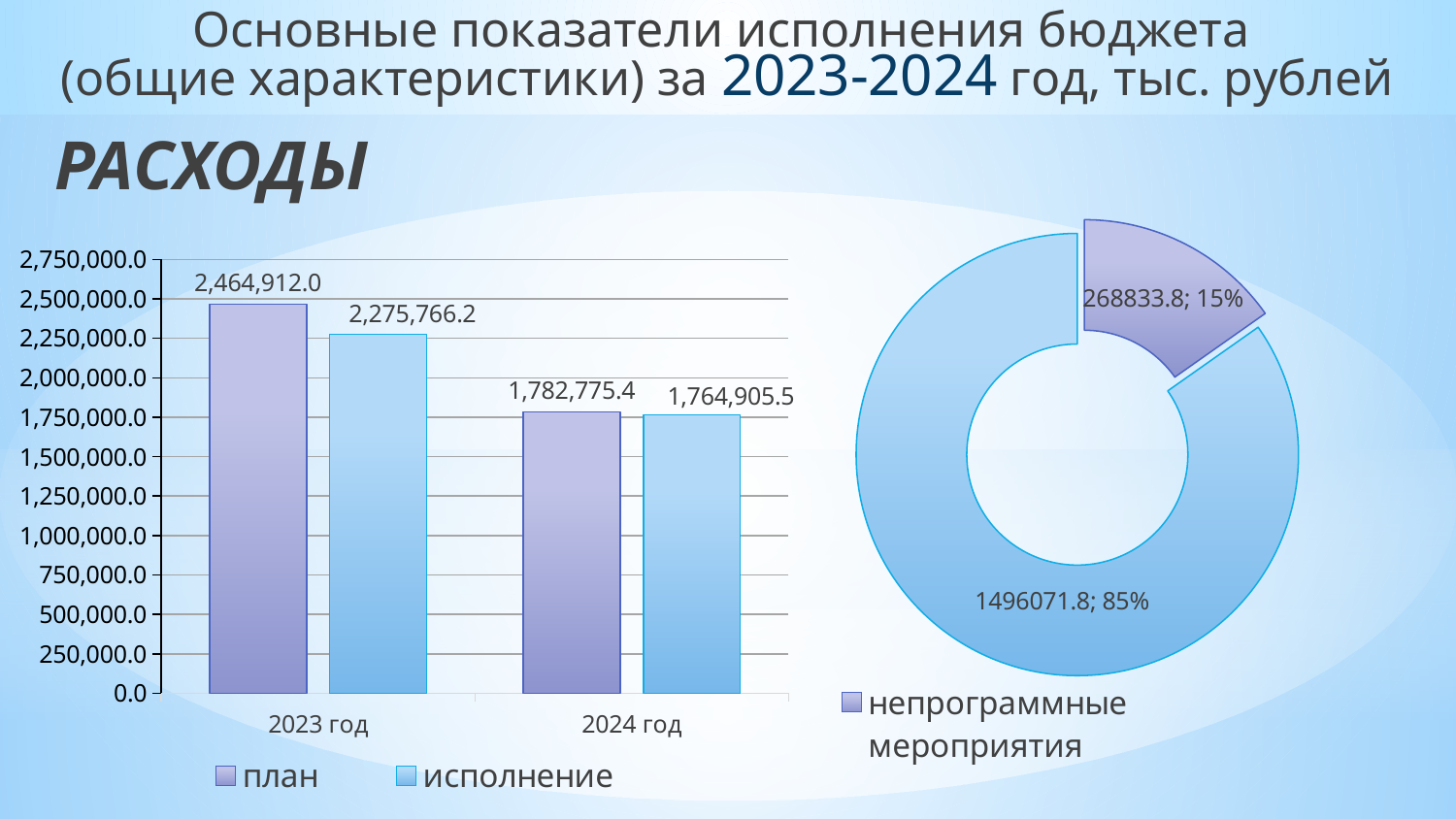
In the bar chart on the left, what is the value of план for 2023 год? 2,464,912.0 In the bar chart on the left, how many series does the legend list? 2 In the bar chart on the left, what is the difference between план and исполнение for 2023 год? 189,145.8 In the bar chart on the left, which bar has the lowest value? исполнение, 2024 год In the bar chart on the left, what is the value of исполнение for 2024 год? 1,764,905.5 In the bar chart on the left, which bar has the highest value? план, 2023 год In the bar chart on the left, do the план values rise or fall from 2023 год to 2024 год? fall In the bar chart on the left, which is larger: план for 2024 год or исполнение for 2023 год? исполнение for 2023 год What type of chart is shown on the right side of the slide? doughnut chart In the bar chart on the left, what is the value of исполнение for 2023 год? 2,275,766.2 In the doughnut chart on the right, what share of the total do непрограммные мероприятия make up? 15% In the bar chart on the left, what is the difference between план for 2023 год and план for 2024 год? 682,136.6